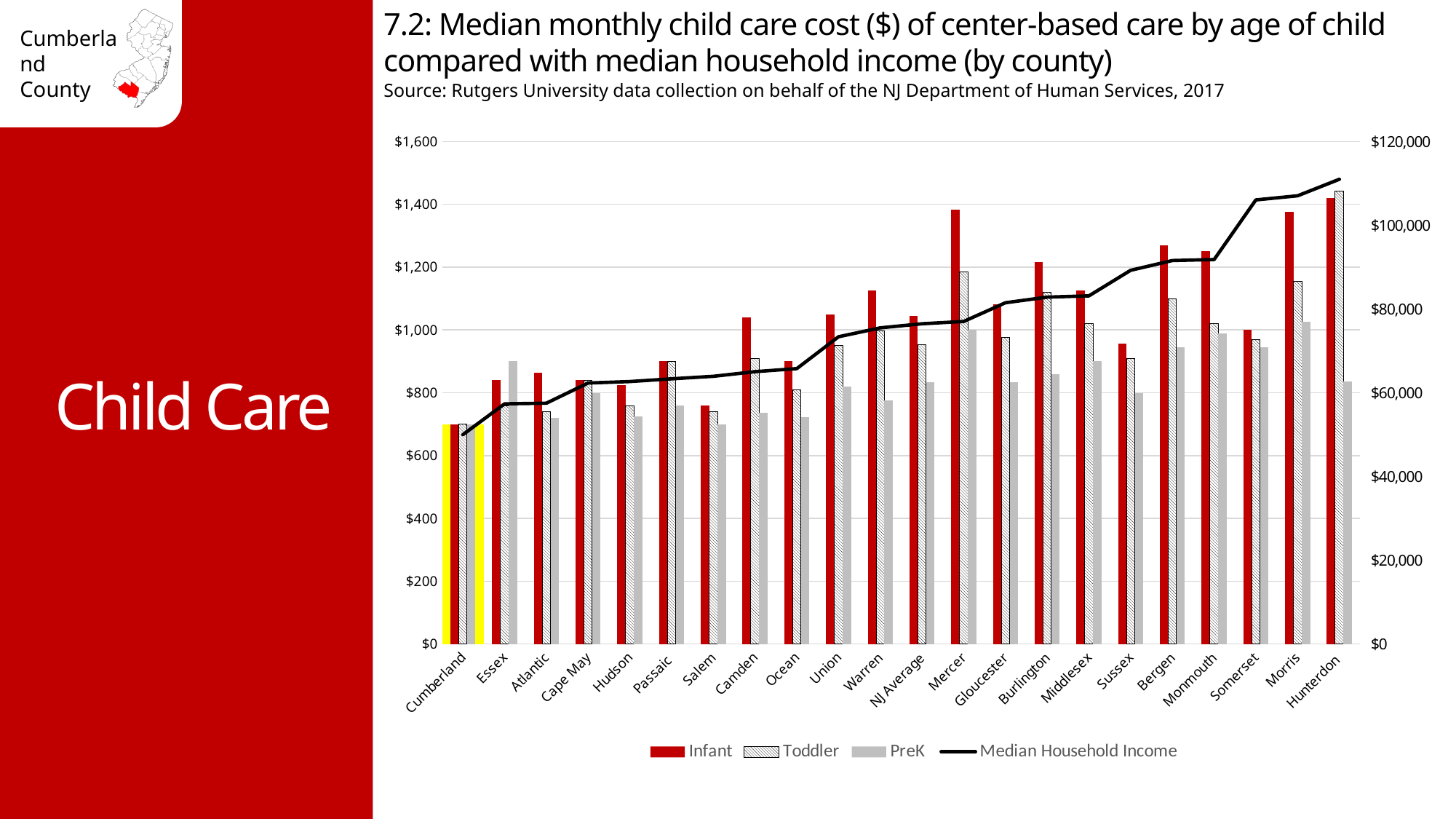
How many series does the legend list? 4 How many counties (including NJ Average) are shown on the x axis? 22 Which is larger, the Infant cost for Mercer or the Infant cost for Gloucester? Mercer Which county has the highest Toddler child care cost? Hunterdon Does the Median Household Income line rise or fall from left to right along the x axis? Rise Is the Median Household Income for Hunterdon greater or less than $100,000? greater Which county has the lowest Infant child care cost? Cumberland Which county's bars are highlighted in yellow? Cumberland Is the Infant cost for Cumberland greater or less than $800? less Which county has the highest Median Household Income? Hunterdon Is the Infant cost for Mercer greater or less than $1,200? greater What kind of chart is this? Bar chart with a line